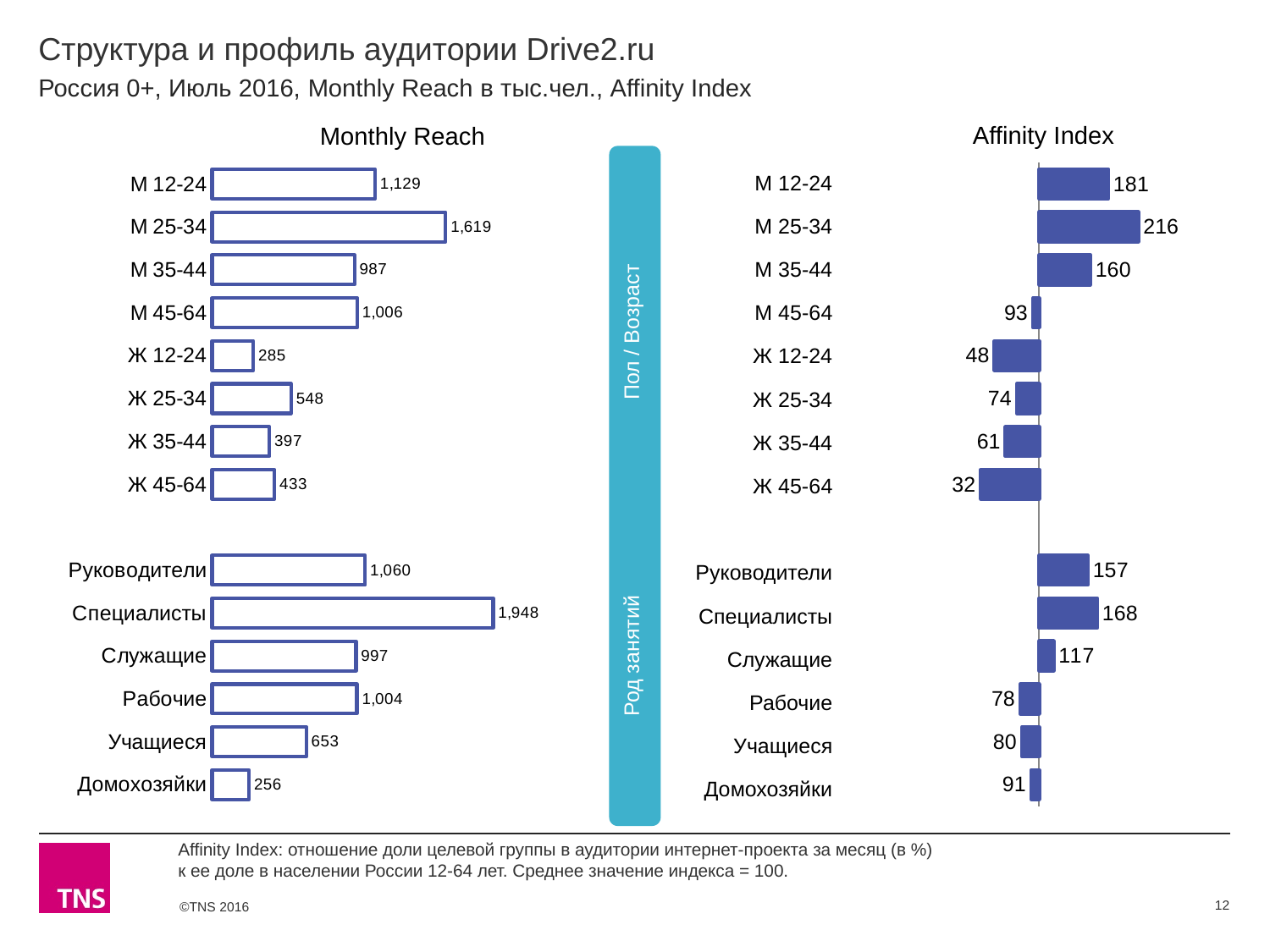
In the Affinity Index chart, what is the difference between the values for М 12-24 and Ж 12-24? 133 How many categories are shown in the Affinity Index chart? 14 In the Affinity Index chart, which category has the highest value? М 25-34 In the Affinity Index chart, which category has the lowest value? Ж 45-64 In the Monthly Reach chart, what is the value for М 25-34? 1,619 In the Monthly Reach chart, which category has the highest value? Специалисты In the Affinity Index chart, what is the value for Ж 45-64? 32 In the Monthly Reach chart, what is the difference between the values for Специалисты and Руководители? 888 In the Monthly Reach chart, which is larger: the value for Ж 25-34 or the value for Ж 45-64? Ж 25-34 In the Monthly Reach chart, what is the value for Домохозяйки? 256 In the Affinity Index chart, what is the value for Служащие? 117 What kind of chart is the Monthly Reach chart? Bar chart